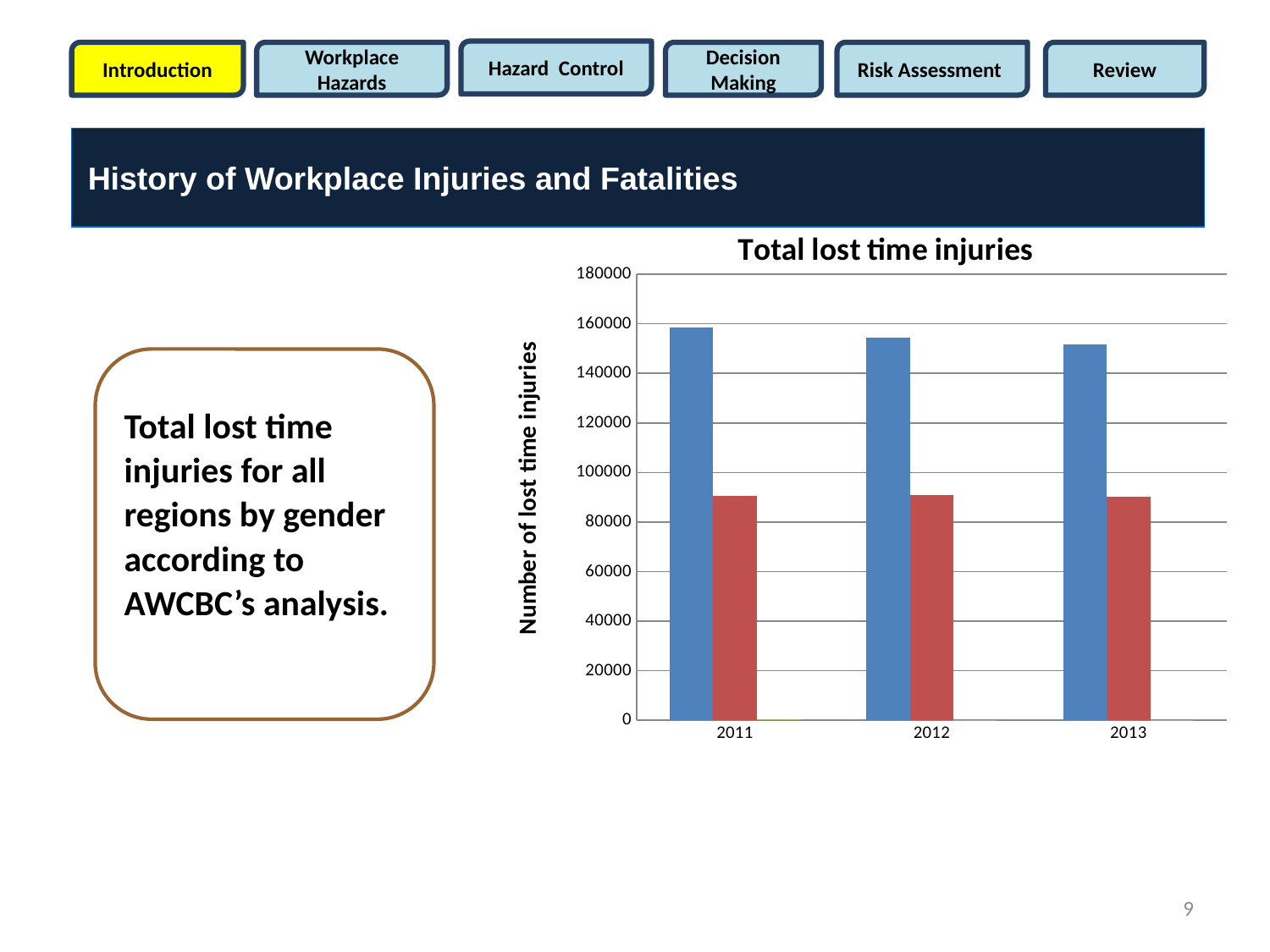
Is the value of the red bar for 2012 greater or less than 100000? less Is the value of the blue bar for 2013 greater or less than 160000? less In which year is the blue bar the lowest? 2013 What kind of chart is shown on the slide? bar chart In which year is the blue bar the highest? 2011 Is the value of the red bar for 2013 greater or less than 80000? greater What is the label on the vertical axis of the chart? Number of lost time injuries How many years are shown on the x axis of the chart? 3 In 2012, which is larger, the blue bar or the red bar? the blue bar Do the blue bars rise or fall from 2011 to 2013? fall What is the title of the chart? Total lost time injuries